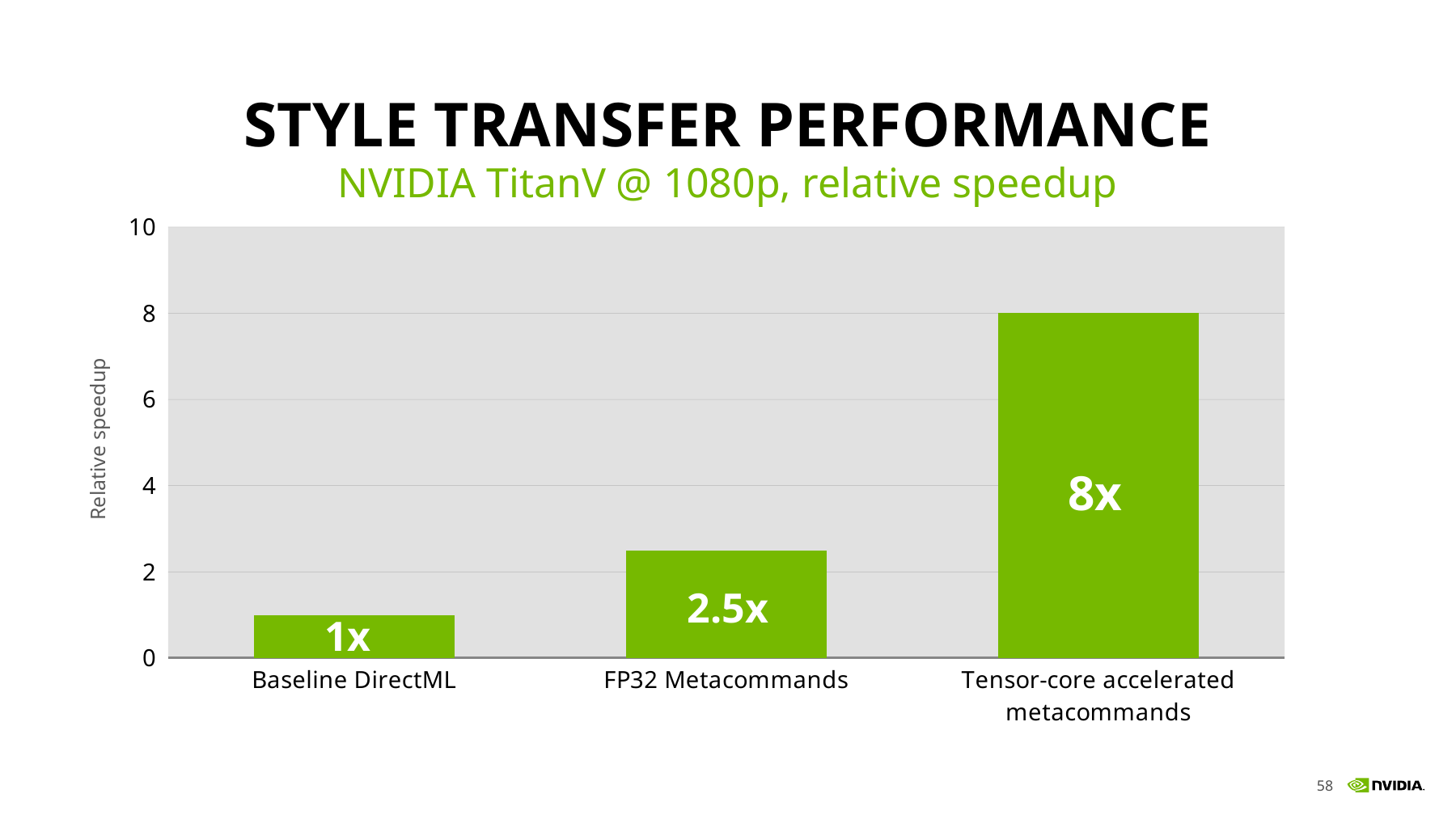
What is the relative speedup for Tensor-core accelerated metacommands? 8x What is the relative speedup for FP32 Metacommands? 2.5x What is the relative speedup for Baseline DirectML? 1x How many categories are shown on the chart? 3 Is the value for Tensor-core accelerated metacommands greater or less than 6? greater Which category has the lowest relative speedup? Baseline DirectML Which has a larger relative speedup, FP32 Metacommands or Baseline DirectML? FP32 Metacommands What kind of chart is shown on the slide? Bar chart Which category has the highest relative speedup? Tensor-core accelerated metacommands Do the values rise or fall from left to right along the x axis? Rise What is the difference in relative speedup between Tensor-core accelerated metacommands and FP32 Metacommands? 5.5x What is the label of the vertical axis? Relative speedup